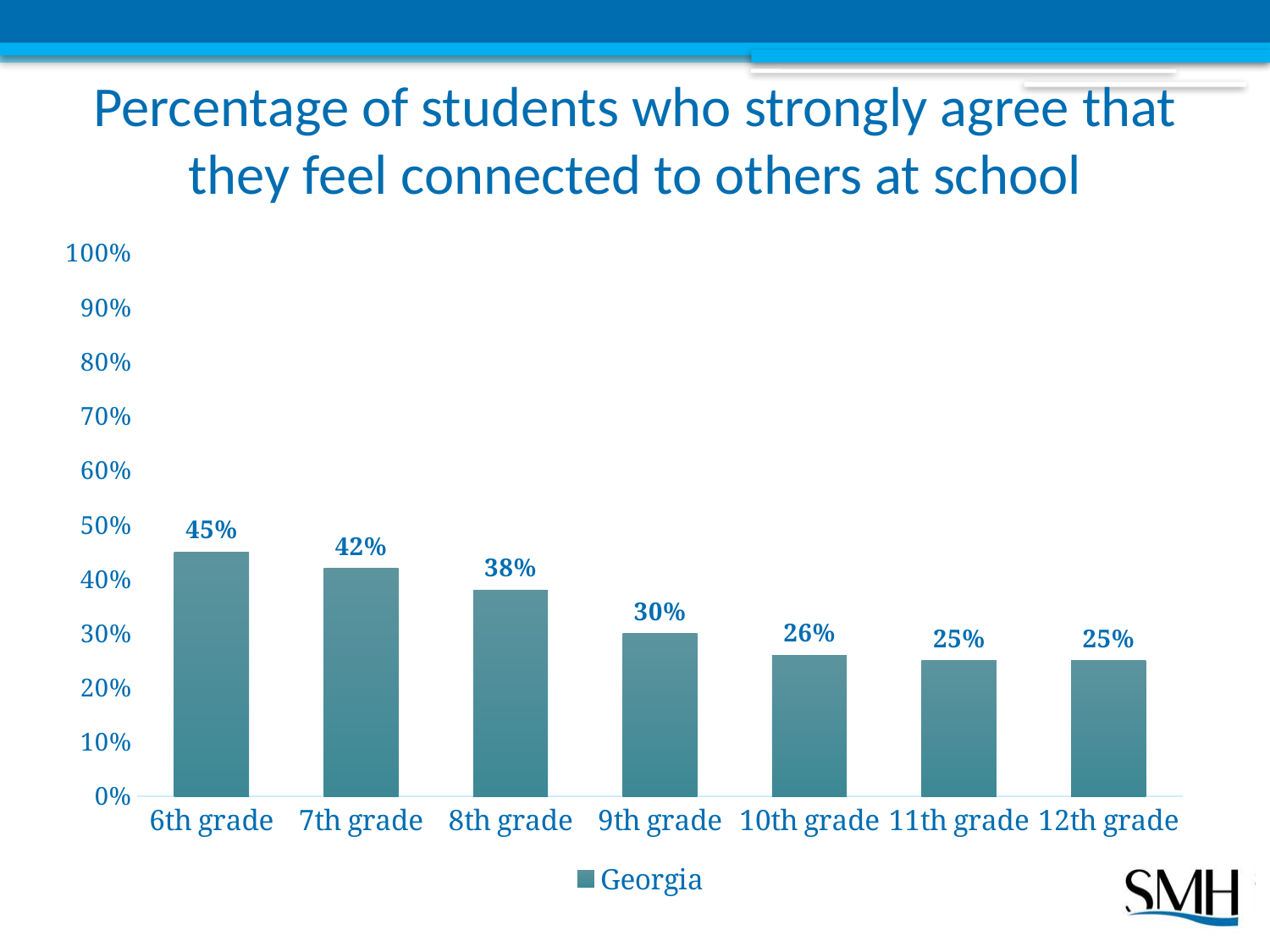
Which is larger, the value for 8th grade or the value for 9th grade? 8th grade What kind of chart is shown on the slide? bar chart What is the value shown for 9th grade? 30% What is the value shown for 10th grade? 26% Do the values rise or fall from 6th grade to 12th grade? fall What is the difference between the values for 7th grade and 8th grade? 4% How many grade categories are shown on the x axis? 7 Which grade has the highest percentage of students who strongly agree they feel connected to others at school? 6th grade How many series does the legend list? 1 What is the difference between the values for 6th grade and 12th grade? 20% What percentage of 6th grade students strongly agree that they feel connected to others at school? 45% Is the value for 7th grade greater or less than 40%? greater